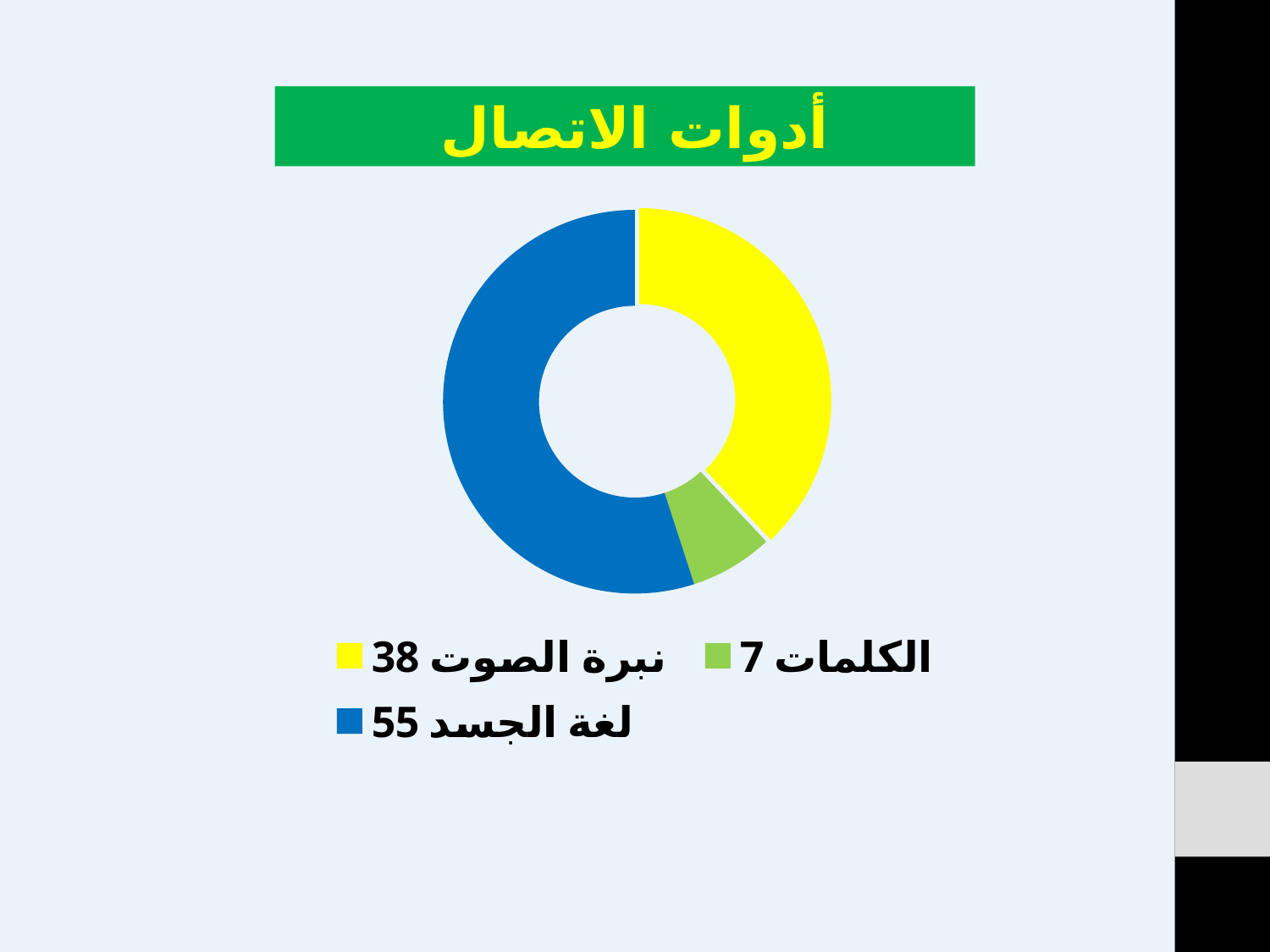
How many categories does the chart show? 3 What value is shown for الكلمات in the legend? 7 Which is larger, نبرة الصوت or الكلمات? نبرة الصوت What is the title of the chart? أدوات الاتصال What value is shown for نبرة الصوت in the legend? 38 What value is shown for لغة الجسد in the legend? 55 Which category has the smallest slice? الكلمات Which category has the largest slice? لغة الجسد What share of the total do the three values give to لغة الجسد? 55% What colour is the slice for الكلمات? Green What kind of chart is shown on the slide? Doughnut (pie) chart What is the difference between the values for لغة الجسد and نبرة الصوت? 17